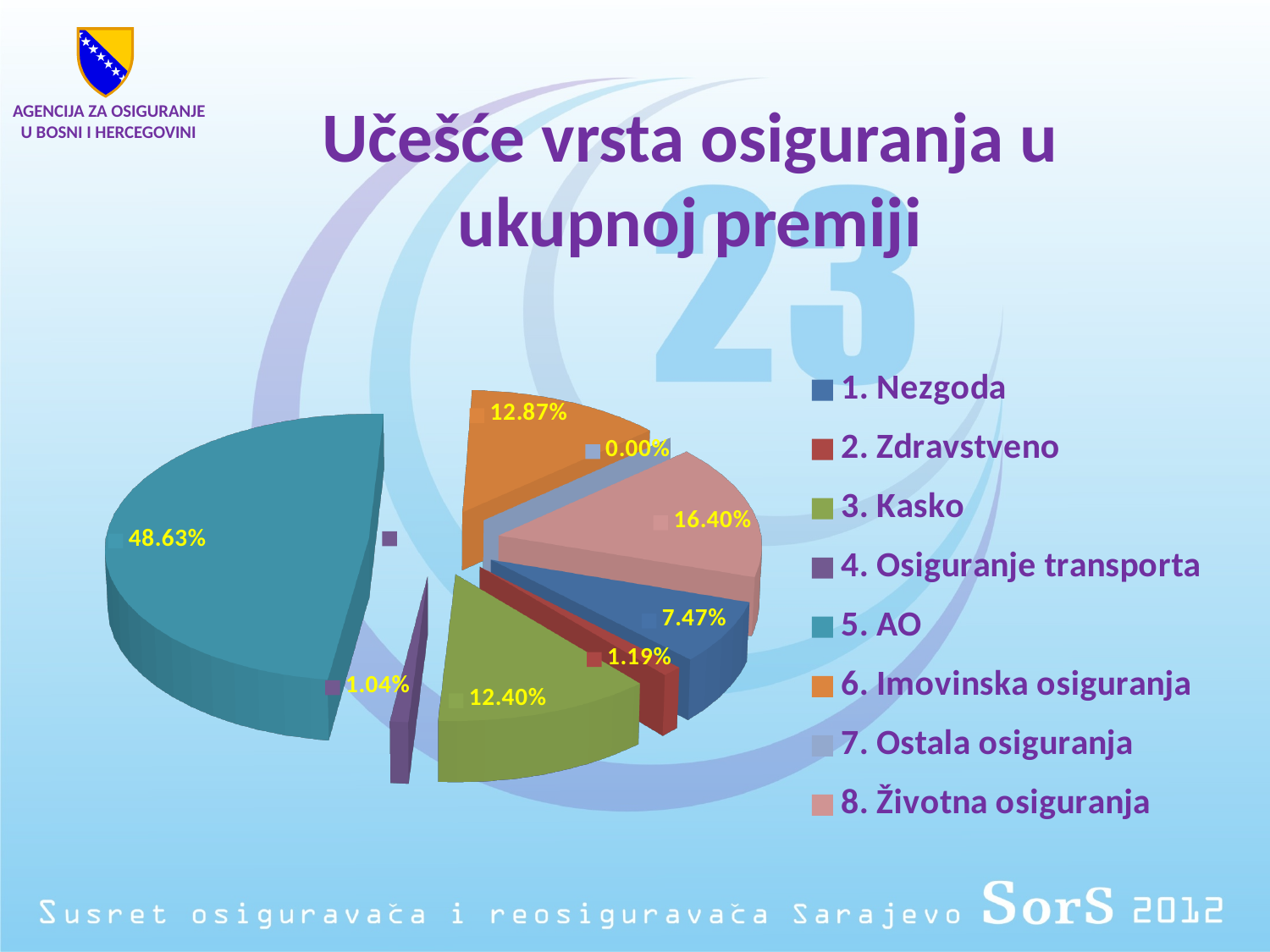
What type of chart is shown on the slide? pie chart How many categories does the legend list? 8 Which category has the smallest share of the pie? 7. Ostala osiguranja What is the share for 8. Životna osiguranja? 16.40% What is the share for 7. Ostala osiguranja? 0.00% What is the share for 3. Kasko? 12.40% What is the title of the chart? Učešće vrsta osiguranja u ukupnoj premiji What is the difference between the shares for 8. Životna osiguranja and 1. Nezgoda? 8.93% Which category has the largest share of the pie? 5. AO What is the share for 5. AO? 48.63% Which is larger, the share for 6. Imovinska osiguranja or 3. Kasko? 6. Imovinska osiguranja What is the share for 1. Nezgoda? 7.47%